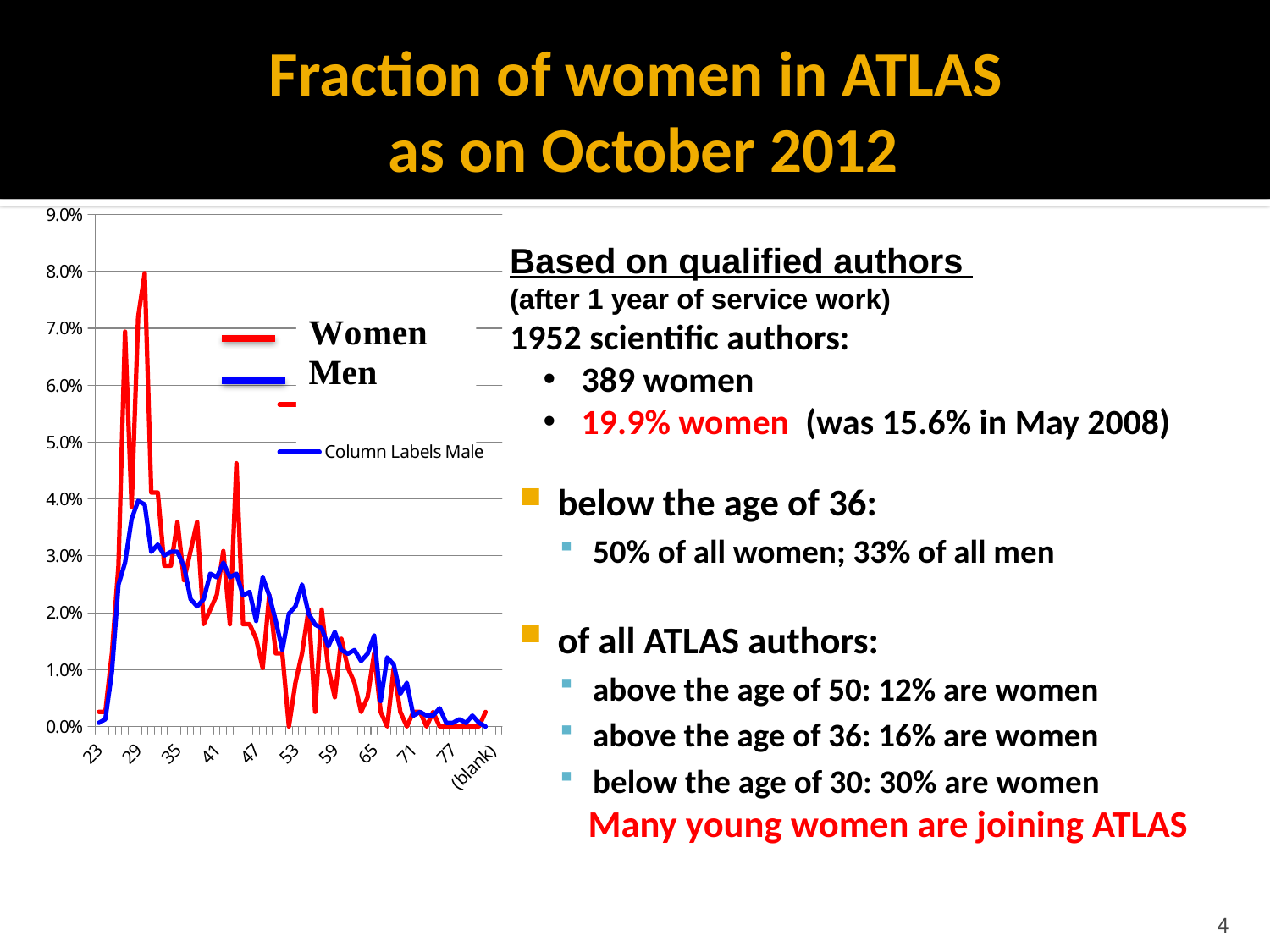
What kind of chart is shown on the slide? line chart Which series reaches the highest value anywhere in the chart, Women or Men? Women After their peak near age 29, do the values for Men generally rise or fall as age increases? fall What colour is the Women line in the chart? red Is the peak value of the Men line greater or less than 5.0%? less Around age 29, which line is higher, Women or Men? Women Is the value of the Women line at age 23 greater or less than 1.0%? less How many data series are plotted in the chart? 2 How many labelled tick marks are shown on the chart's horizontal axis? 11 Is the peak value of the Men line greater or less than 3.0%? greater What is the highest value shown on the chart's vertical axis? 9.0%